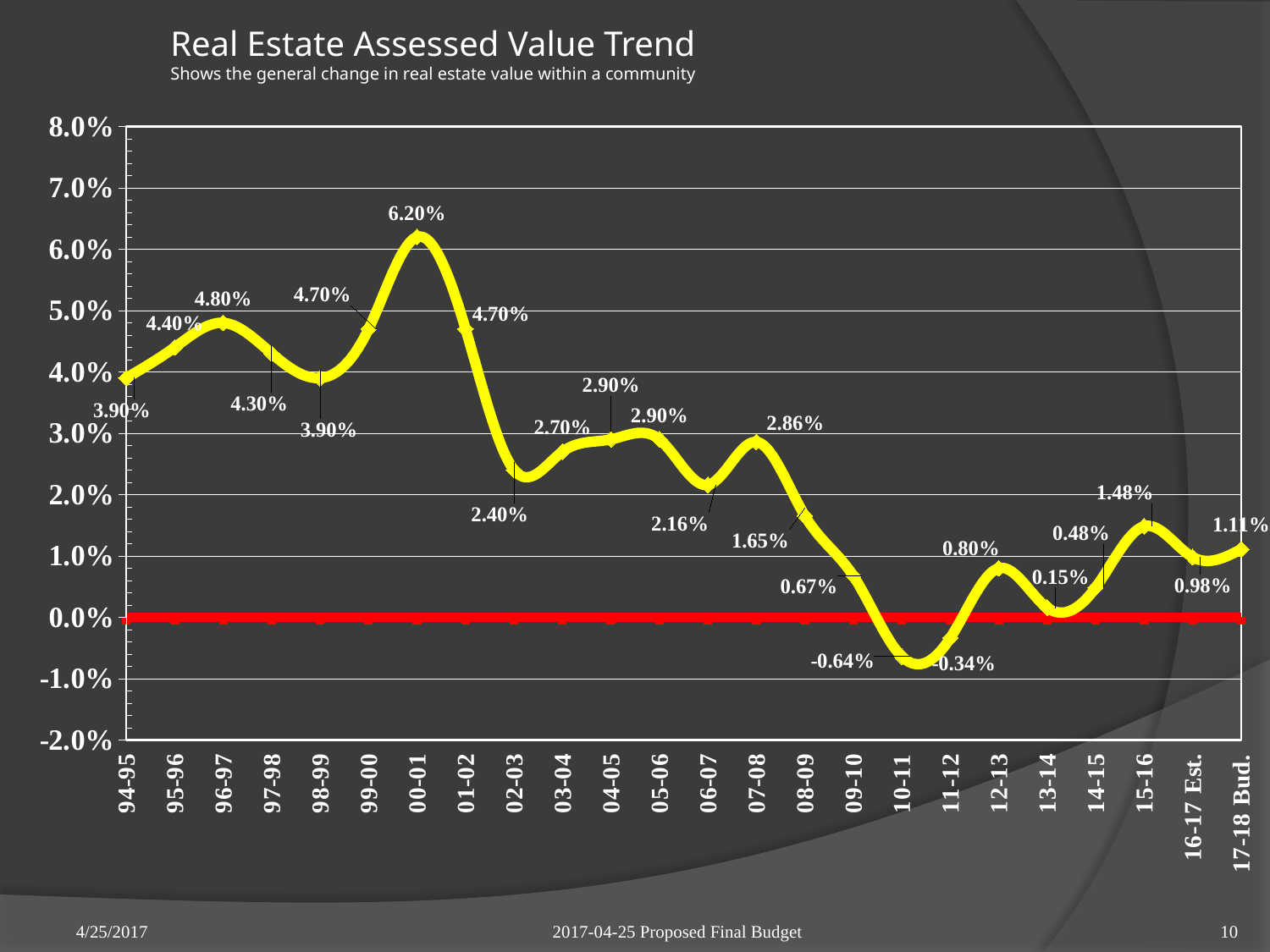
Which year has the lowest value? 10-11 Which is larger, the value for 15-16 or the value for 16-17 Est.? 15-16 What kind of chart is shown on the slide? line chart What is the difference between the values for 00-01 and 01-02? 1.50% What is the value for 17-18 Bud.? 1.11% What is the value for 07-08? 2.86% Which year has the highest value? 00-01 How many years are plotted on the x axis? 24 What is the value for 00-01? 6.20% What is the value for 10-11? -0.64% Is the value for 96-97 greater or less than 4.0%? greater Do the values generally rise or fall from 94-95 to 17-18 Bud.? fall